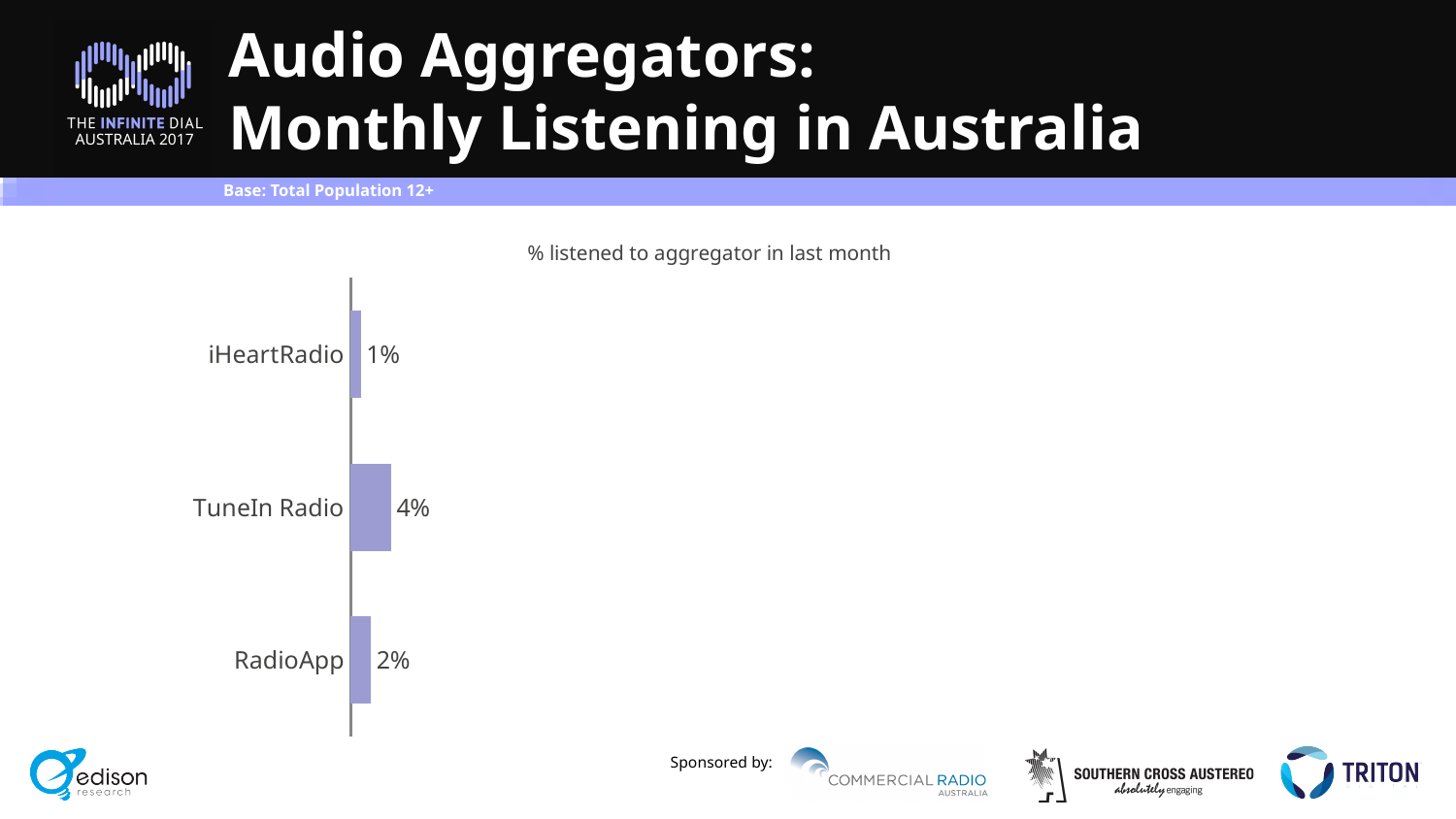
What kind of chart is shown on the slide? Bar chart What is the title of the chart? % listened to aggregator in last month Which aggregator has the highest monthly listening? TuneIn Radio Which aggregator has the lowest monthly listening? iHeartRadio What base population is stated for the chart? Total Population 12+ What is the value shown for iHeartRadio? 1% Which has a larger value, RadioApp or iHeartRadio? RadioApp What is the value shown for RadioApp? 2% What is the difference between the values for RadioApp and iHeartRadio? 1% What is the difference between the values for TuneIn Radio and RadioApp? 2% What percentage listened to TuneIn Radio in the last month? 4% How many aggregators are shown in the chart? 3